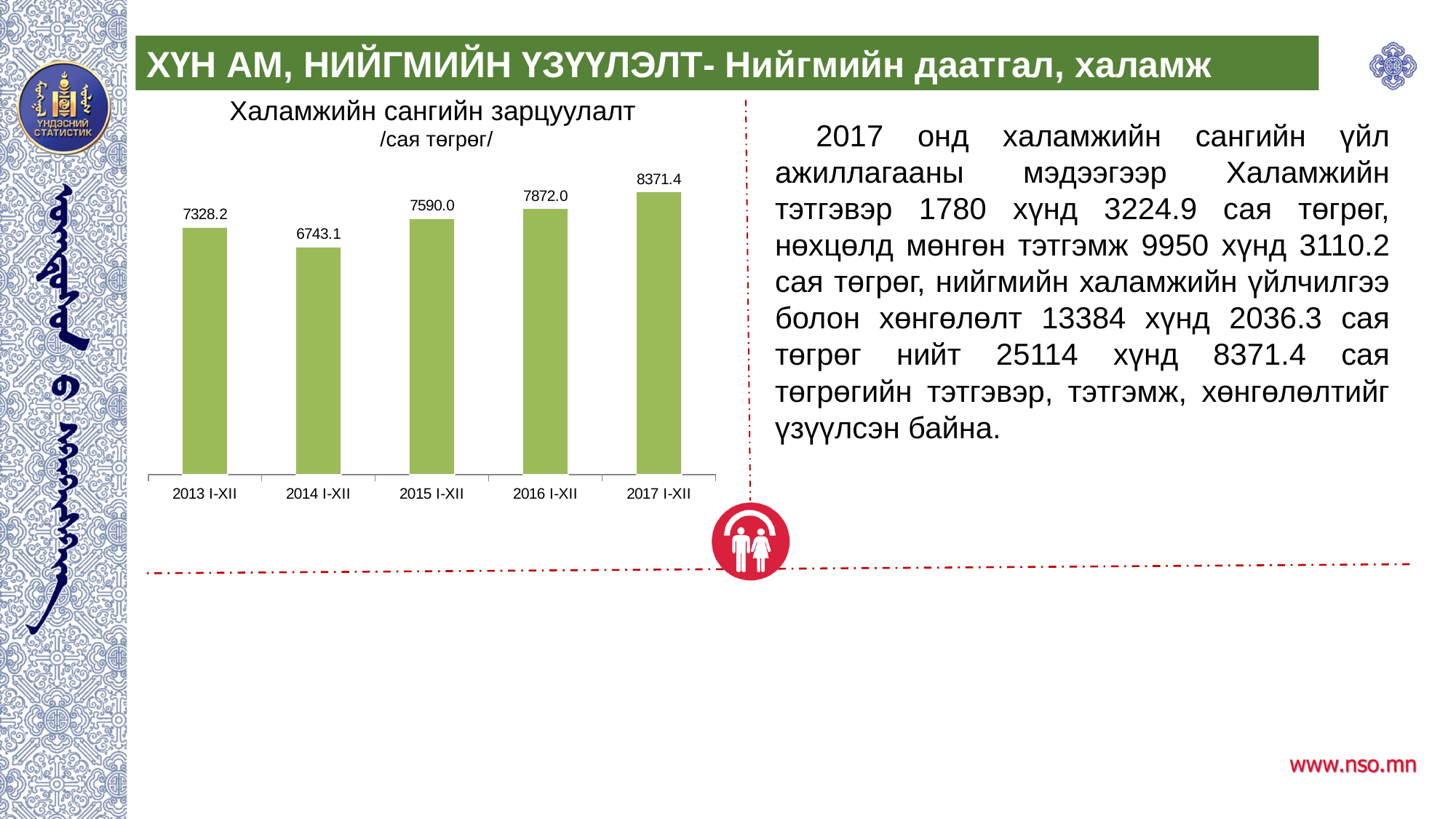
What is the value for 2017 I-XII? 8371.4 What is the value for 2015 I-XII? 7590.0 What is the value for 2016 I-XII? 7872.0 What is the value for 2013 I-XII? 7328.2 How many periods are shown on the x axis? 5 What is the value for 2014 I-XII? 6743.1 What is the difference between the values for 2017 I-XII and 2016 I-XII? 499.4 Which period has the highest value? 2017 I-XII What is the title of the chart? Халамжийн сангийн зарцуулалт What kind of chart is shown? Bar chart Which is larger, the value for 2013 I-XII or 2015 I-XII? 2015 I-XII Which period has the lowest value? 2014 I-XII